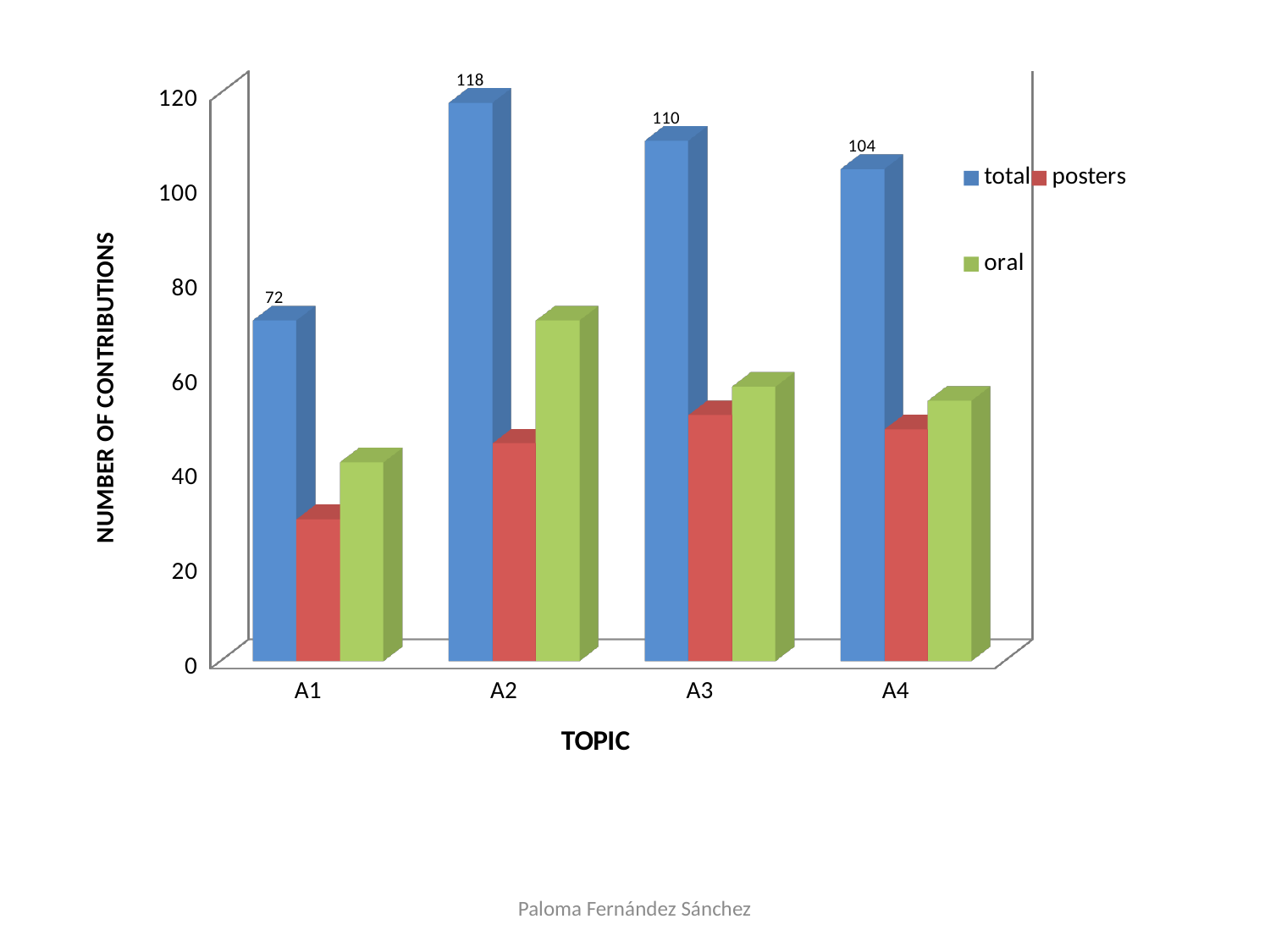
How many series does the legend list? 3 Which topic has the highest total number of contributions? A2 What kind of chart is shown on the slide? bar chart Which topic has the lowest total number of contributions? A1 Which has a larger total number of contributions, A3 or A4? A3 Is the number of posters for topic A1 greater or less than 40? less What is the total number of contributions for topic A1? 72 What is the total number of contributions for topic A4? 104 Is the number of oral contributions for topic A2 greater or less than 60? greater What is the difference between the total contributions for A2 and A3? 8 What is the total number of contributions for topic A2? 118 What is the difference between the total contributions for A3 and A1? 38